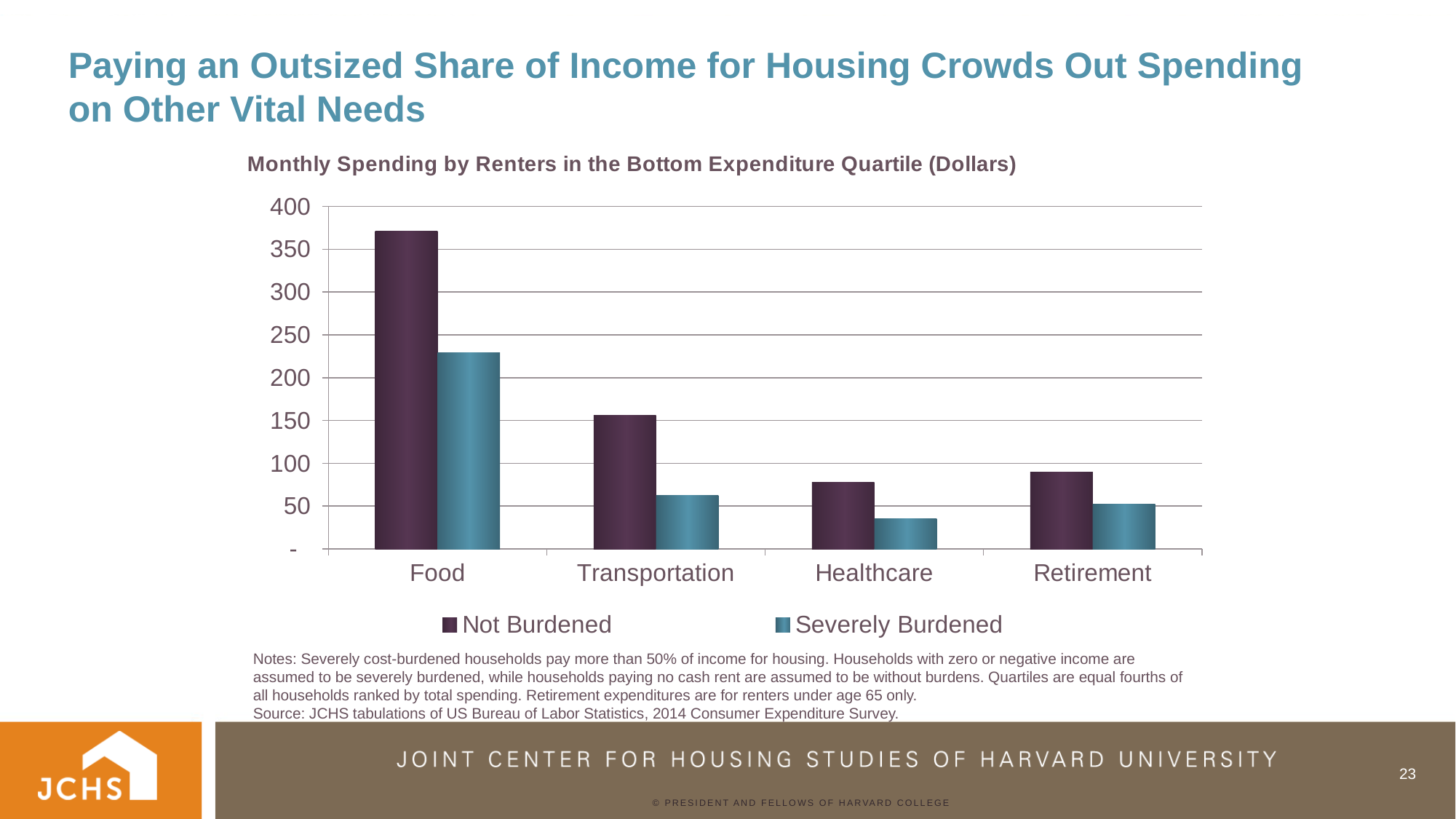
Which is larger: the Severely Burdened value for Retirement or the Severely Burdened value for Healthcare? Retirement Which category has the lowest Not Burdened spending? Healthcare Is the Not Burdened value for Food greater or less than 350? greater Which category has the highest Not Burdened spending? Food Which category has the lowest Severely Burdened spending? Healthcare How many series does the legend list? 2 How many spending categories are shown on the x axis? 4 What kind of chart is shown on the slide? bar chart Is the Severely Burdened value for Transportation greater or less than 100? less What is the title of the chart? Monthly Spending by Renters in the Bottom Expenditure Quartile (Dollars) For Food, which series has the larger value: Not Burdened or Severely Burdened? Not Burdened